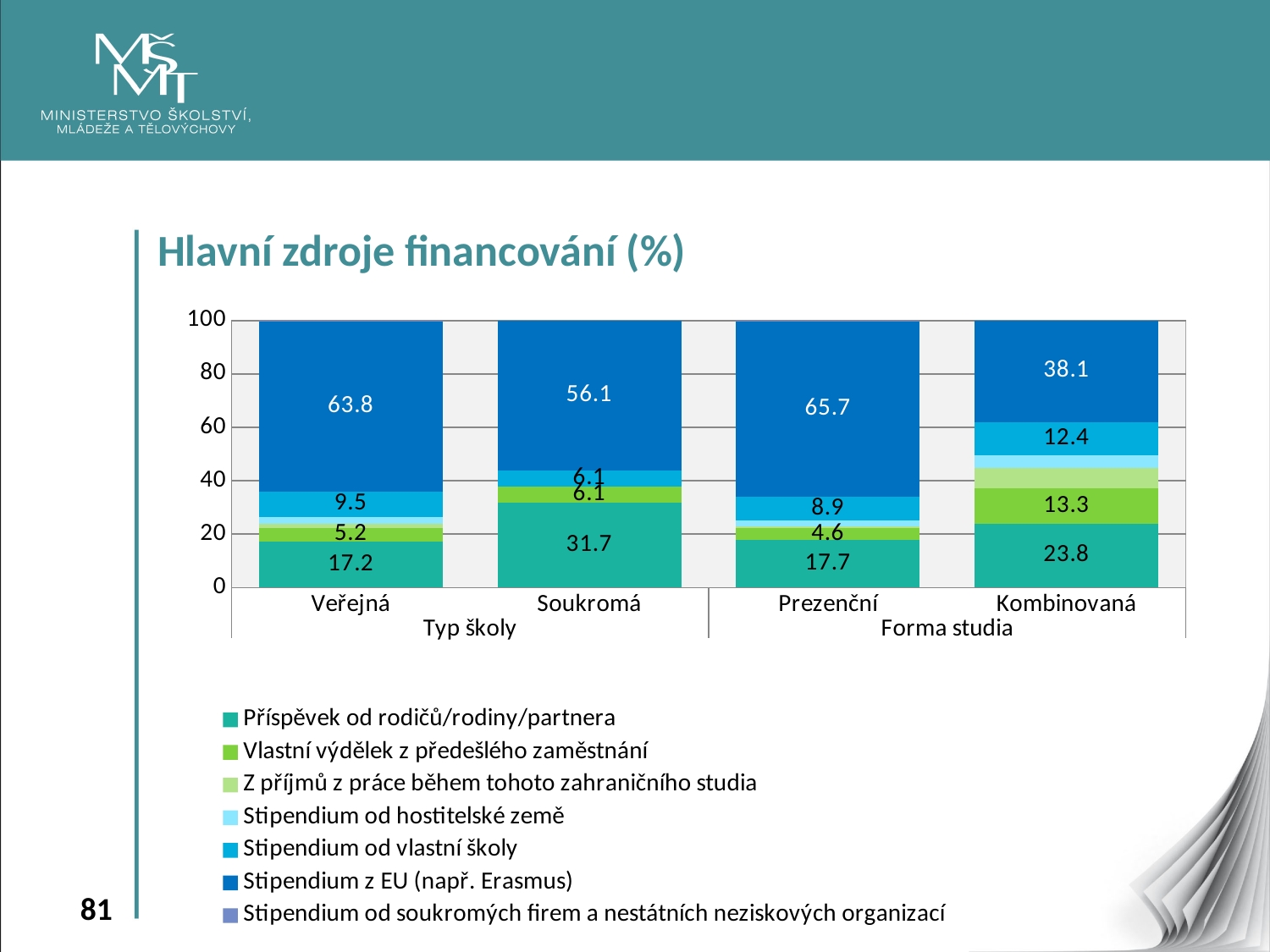
What is the difference between the Stipendium z EU (např. Erasmus) values for Veřejná and Soukromá? 7.7 What is the value of Stipendium z EU (např. Erasmus) for Veřejná? 63.8 Which category has the highest value for Stipendium z EU (např. Erasmus)? Prezenční Which is larger: Vlastní výdělek z předešlého zaměstnání for Kombinovaná or for Veřejná? Kombinovaná What type of chart is shown on the slide? stacked bar chart How many categories are shown on the x axis? 4 What is the value of Stipendium od vlastní školy for Kombinovaná? 12.4 Which category has the lowest value for Příspěvek od rodičů/rodiny/partnera? Veřejná What is the value of Příspěvek od rodičů/rodiny/partnera for Soukromá? 31.7 How many series does the legend list? 7 What is the value of Vlastní výdělek z předešlého zaměstnání for Prezenční? 4.6 What is the title of the chart? Hlavní zdroje financování (%)